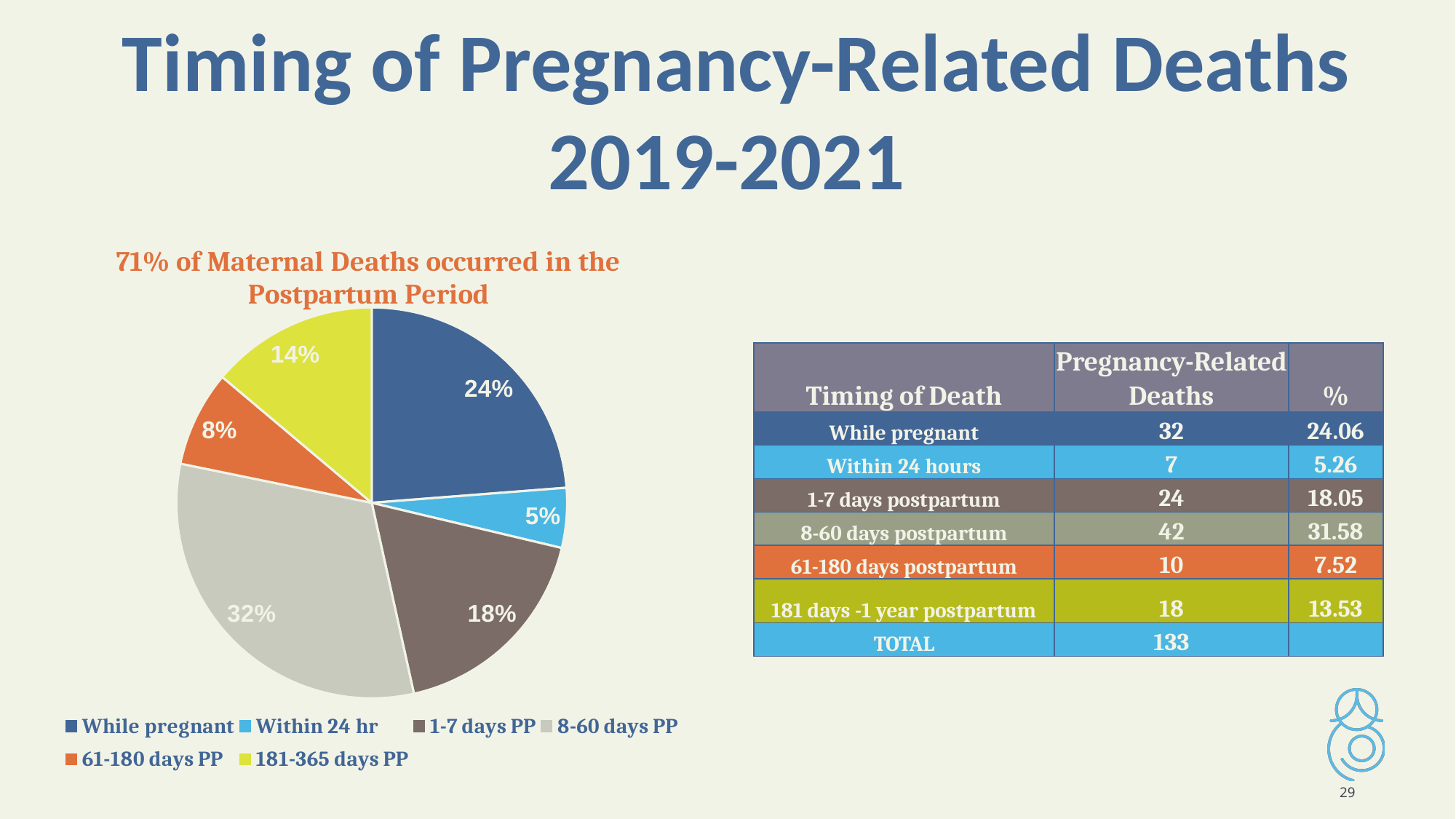
What percentage of the pie chart is labelled for the 'While pregnant' slice? 24% What colour is the '61-180 days PP' slice in the pie chart? orange What is the title shown above the pie chart? 71% of Maternal Deaths occurred in the Postpartum Period What percentage is shown for the '8-60 days PP' slice of the pie chart? 32% Which category has the largest slice in the pie chart? 8-60 days PP What percentage is shown for the '181-365 days PP' slice of the pie chart? 14% How many categories does the pie chart legend list? 6 What is the difference in percentage points between the '8-60 days PP' slice and the 'While pregnant' slice in the pie chart? 8 Which category has the smallest slice in the pie chart? Within 24 hr What type of chart is shown on the slide? pie chart What percentage is shown for the 'Within 24 hr' slice of the pie chart? 5% In the pie chart, which slice is larger: '1-7 days PP' or '61-180 days PP'? 1-7 days PP